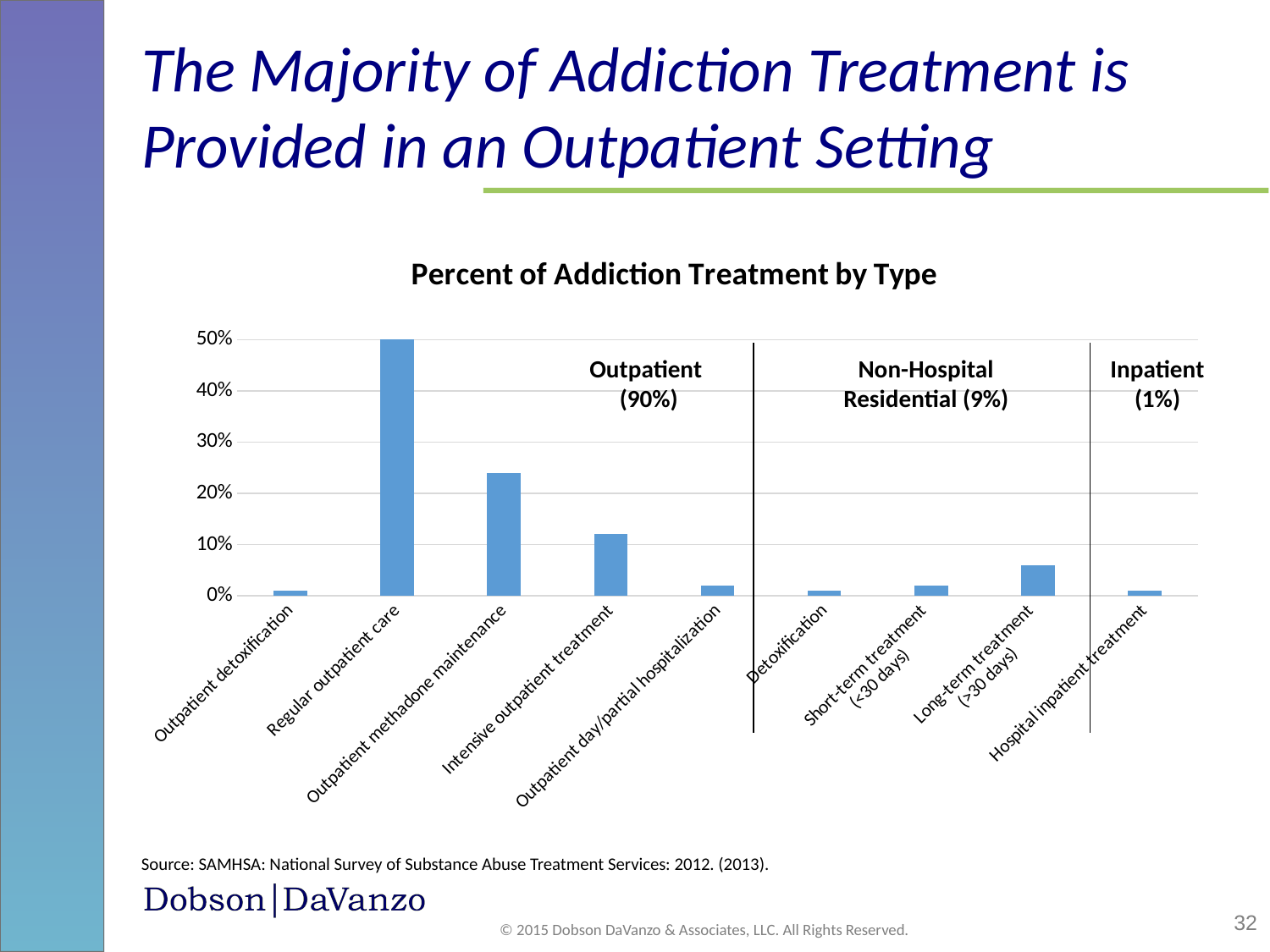
According to the group label on the chart, what percent of addiction treatment is provided in the Outpatient setting? 90% What is the value for Regular outpatient care? 50% Which treatment type has the highest percentage? Regular outpatient care What kind of chart is shown on the slide? bar chart Which is larger, Long-term treatment (>30 days) or Short-term treatment (<30 days)? Long-term treatment (>30 days) Is the value for Intensive outpatient treatment greater or less than 10%? greater How many treatment types are plotted on the chart? 9 Is the value for Outpatient day/partial hospitalization greater or less than 10%? less Is the value for Long-term treatment (>30 days) greater or less than 10%? less What is the title of the chart? Percent of Addiction Treatment by Type Which is larger, Outpatient methadone maintenance or Intensive outpatient treatment? Outpatient methadone maintenance